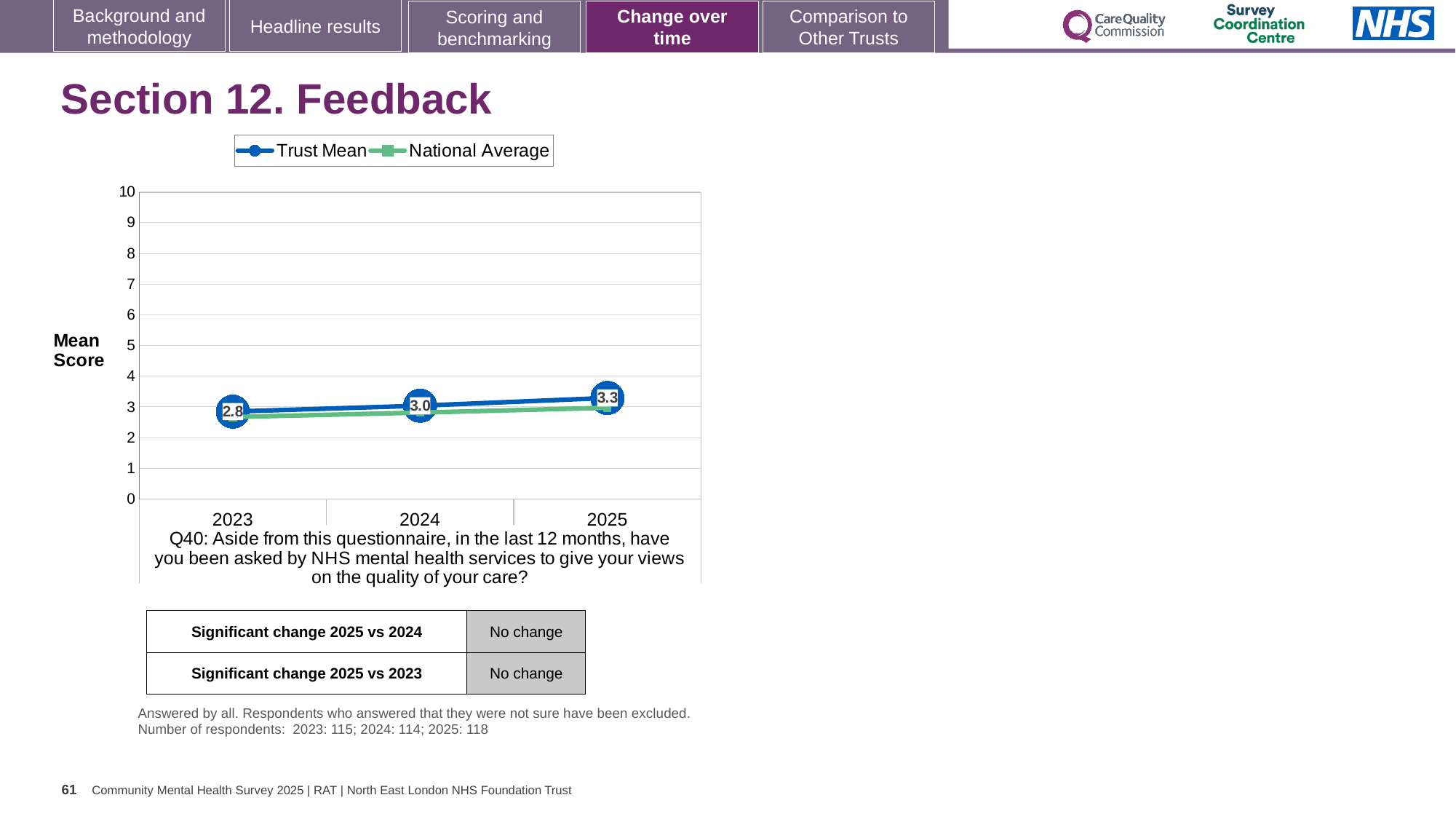
What is the Trust Mean value for 2024? 3.0 In which year is the Trust Mean highest? 2025 Does the Trust Mean rise or fall from 2023 to 2025? rise What is the Trust Mean value for 2025? 3.3 Which is larger, the Trust Mean in 2024 or the Trust Mean in 2025? 2025 What kind of chart is shown on the slide? line chart How many years are plotted on the x axis? 3 How many series does the legend list? 2 Is the National Average value for 2025 greater or less than 5? less What is the Trust Mean value for 2023? 2.8 In which year is the Trust Mean lowest? 2023 What is the difference between the Trust Mean in 2025 and in 2023? 0.5